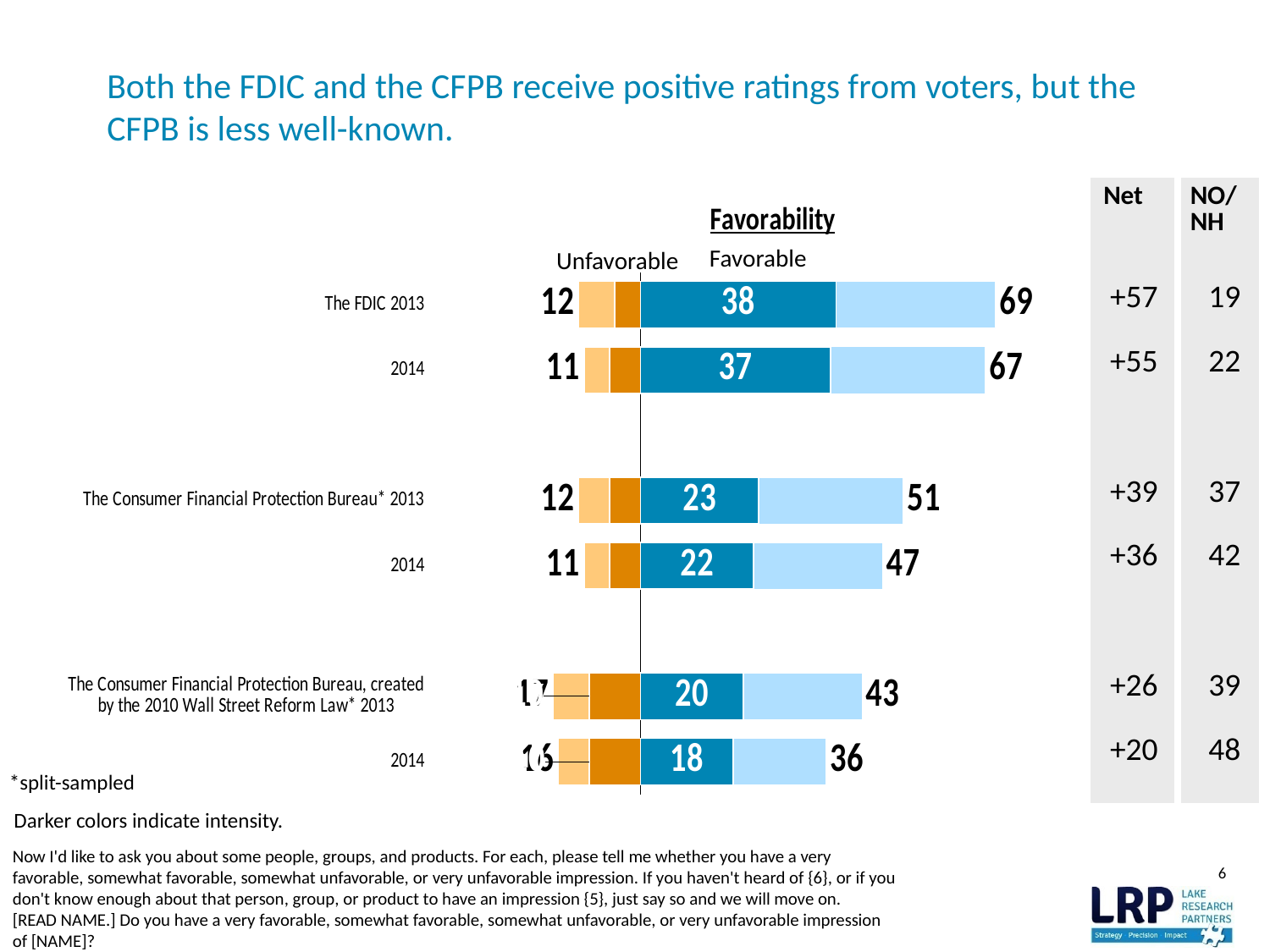
What is the very favorable (darker blue) value for The FDIC in 2014? 37 What is the difference between the total favorable rating for The FDIC in 2013 and in 2014? 2 Which row has the lowest total favorable rating? The Consumer Financial Protection Bureau, created by the 2010 Wall Street Reform Law 2014 What is the unfavorable rating for The Consumer Financial Protection Bureau in 2013? 12 Which is larger: the very favorable value for The Consumer Financial Protection Bureau in 2013 or for the CFPB created by the 2010 Wall Street Reform Law in 2013? The Consumer Financial Protection Bureau 2013 Which row has the highest total favorable rating? The FDIC 2013 How many bars (rows) are plotted in the chart? 6 What is the total favorable rating for The FDIC in 2013? 69 What is the title of the chart? Favorability What kind of chart is shown on the slide? Bar chart What is the total favorable rating for The Consumer Financial Protection Bureau in 2014? 47 What is the difference between the total favorable rating for The FDIC in 2014 and The Consumer Financial Protection Bureau in 2014? 20